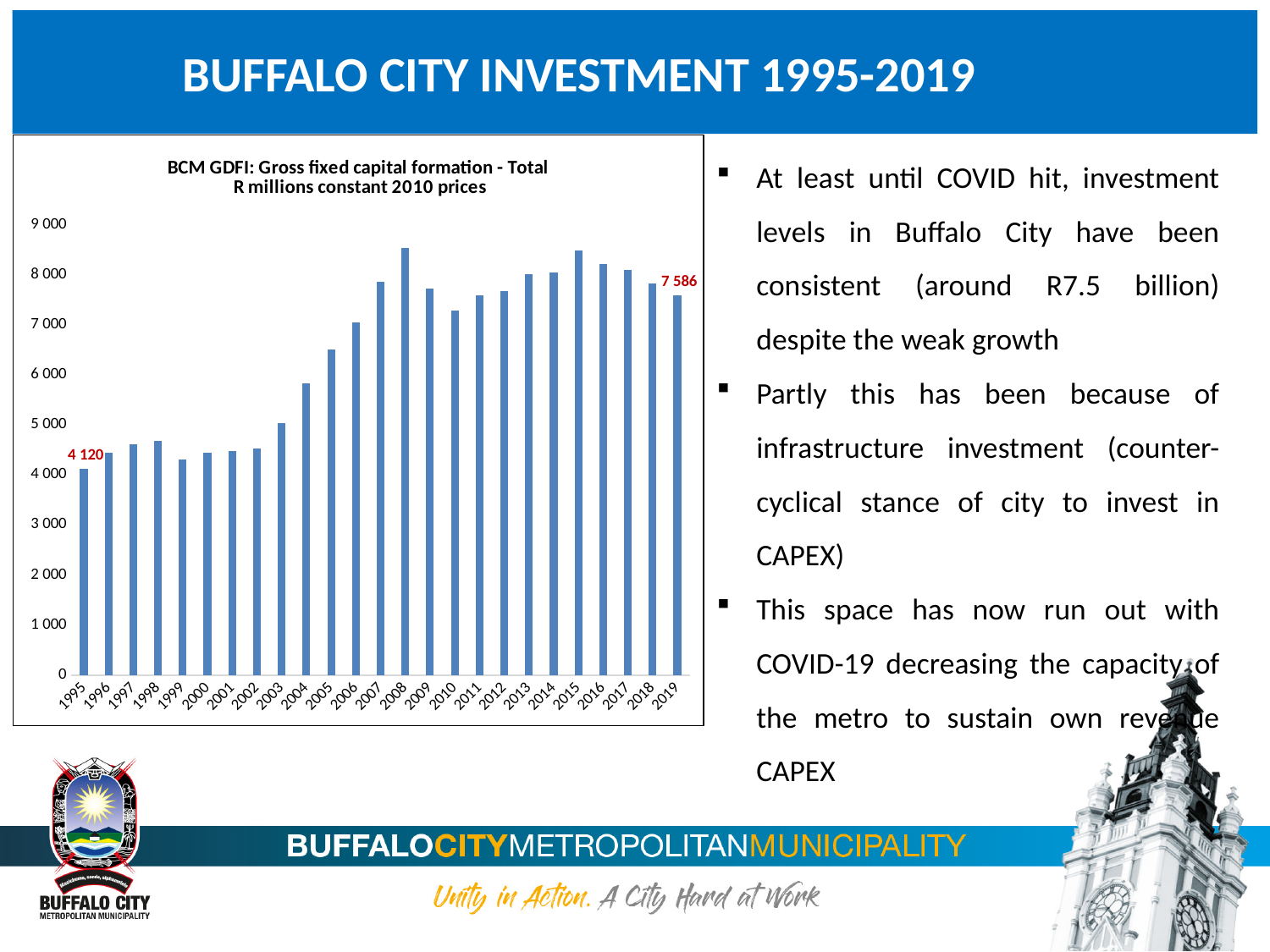
Is the value for 2004 greater or less than 5 000? greater What is the value for 2019? 7 586 How many years are plotted on the chart? 25 What kind of chart is shown on the slide? bar chart Is the value for 2005 greater or less than 6 000? greater What is the value for 1995? 4 120 Is the value for 2008 greater or less than 8 000? greater Which is larger, the value for 2019 or the value for 1995? 2019 What is the difference between the values for 2019 and 1995? 3 466 Which is larger, the value for 2008 or the value for 2000? 2008 Do the values generally rise or fall from 1995 to 2019? rise